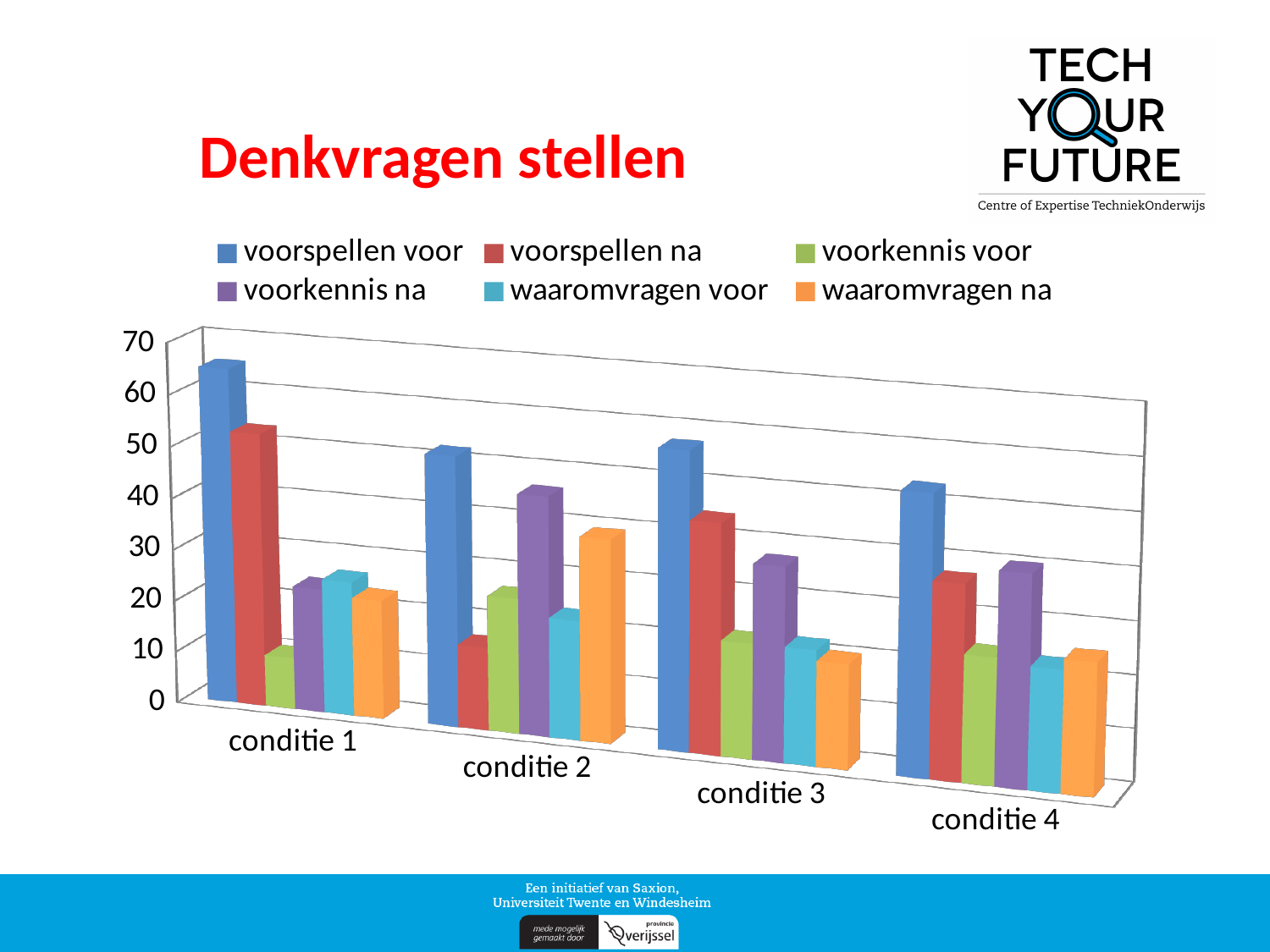
Which series has the highest value for conditie 2? voorspellen voor Which series has the lowest value for conditie 1? voorkennis voor What is the title of the slide containing the chart? Denkvragen stellen Which is larger for conditie 3: voorspellen na or voorkennis voor? voorspellen na Which is larger: voorspellen voor for conditie 1 or voorspellen voor for conditie 4? conditie 1 Is the value of voorspellen voor for conditie 1 greater or less than 50? greater How many series does the chart's legend list? 6 How many categories (conditions) are shown on the x axis of the chart? 4 Which series has the highest value for conditie 1? voorspellen voor What kind of chart is shown on the slide? bar chart Is the value of voorspellen na for conditie 2 greater or less than 20? less Is the value of waaromvragen na for conditie 2 greater or less than 20? greater